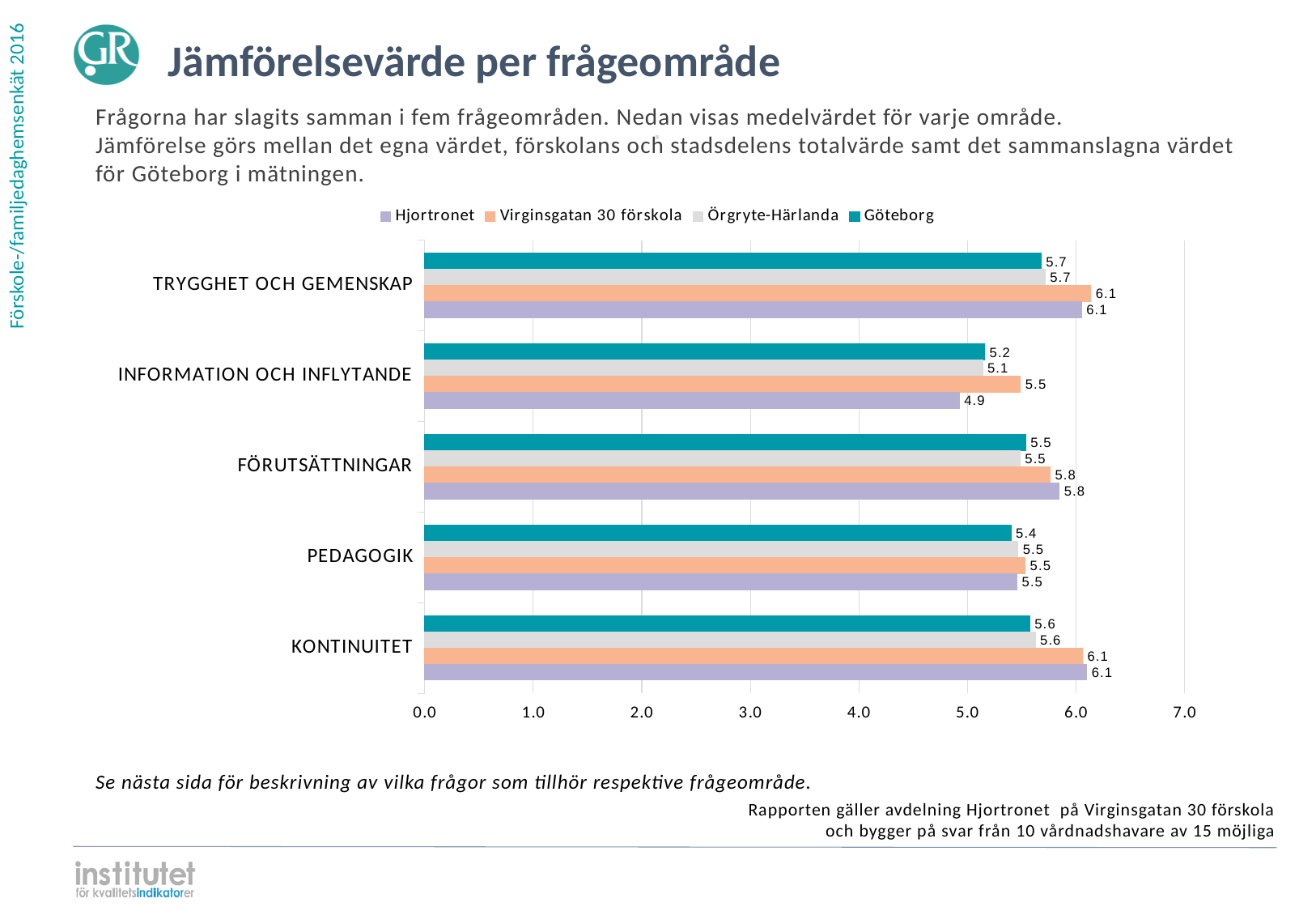
What is the difference between the Virginsgatan 30 förskola value and the Hjortronet value in the INFORMATION OCH INFLYTANDE category? 0.6 How many series does the legend list? 4 What is the value for Göteborg in the PEDAGOGIK category? 5.4 What is the title of the chart on the slide? Jämförelsevärde per frågeområde What is the value for Hjortronet in the INFORMATION OCH INFLYTANDE category? 4.9 Which is larger in the TRYGGHET OCH GEMENSKAP category: the value for Hjortronet or the value for Göteborg? Hjortronet In which category does Hjortronet have its lowest value? INFORMATION OCH INFLYTANDE In which category does Göteborg have its highest value? TRYGGHET OCH GEMENSKAP What is the value for Virginsgatan 30 förskola in the FÖRUTSÄTTNINGAR category? 5.8 What is the value for Örgryte-Härlanda in the KONTINUITET category? 5.6 How many categories are shown on the y axis of the chart? 5 What kind of chart is shown on the slide? Bar chart